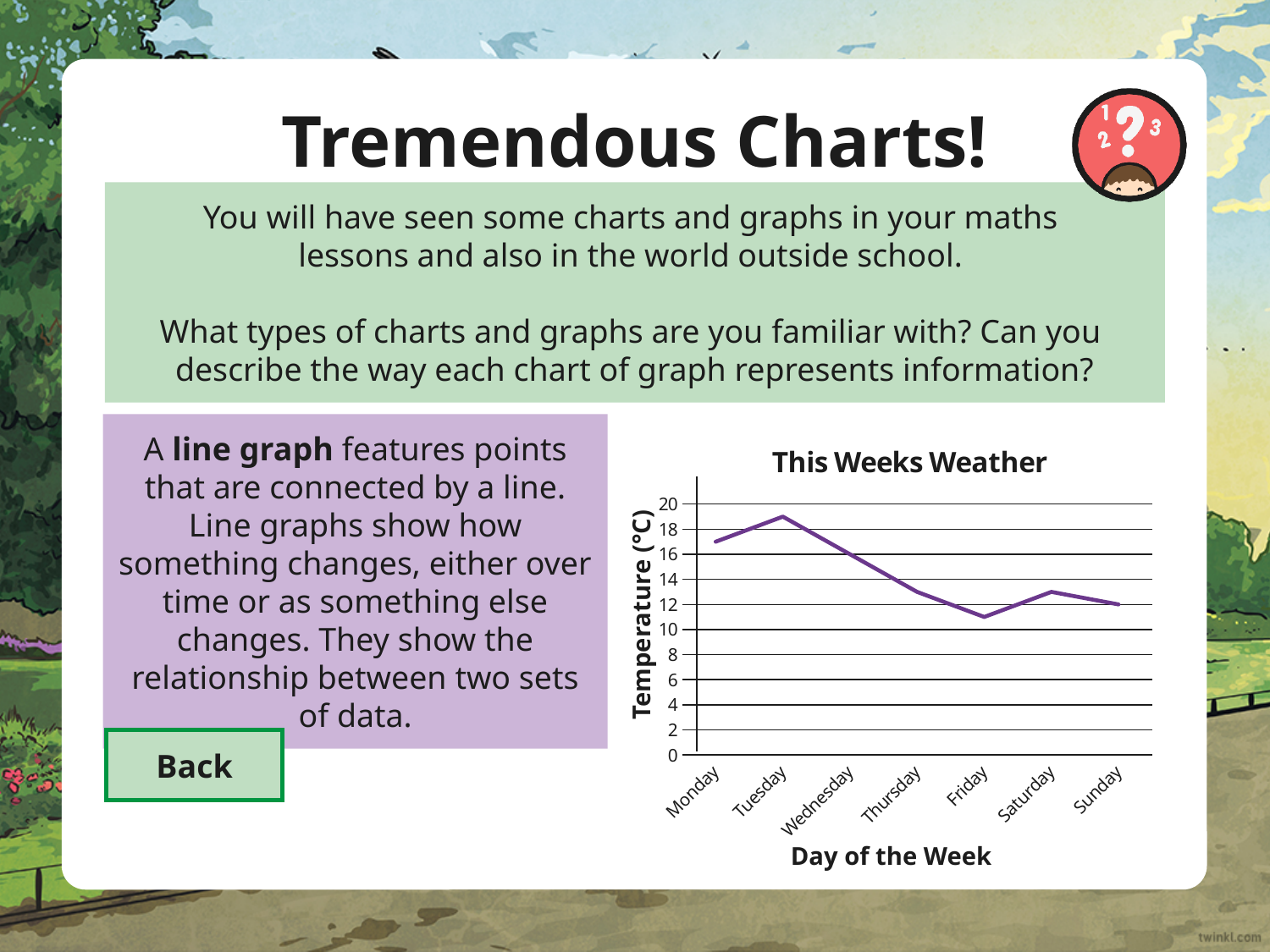
Is the temperature for Friday greater or less than 12? less How many days are plotted on the chart? 7 Which day has a higher temperature, Monday or Thursday? Monday What is the label on the vertical axis of the chart? Temperature (°C) Which day has the highest temperature? Tuesday What is the title of the chart? This Weeks Weather Which day has the lowest temperature? Friday Is the temperature for Monday greater or less than 16? greater What kind of chart is shown on the slide? line chart Does the temperature rise or fall from Tuesday to Friday? fall Is the temperature for Thursday greater or less than 14? less